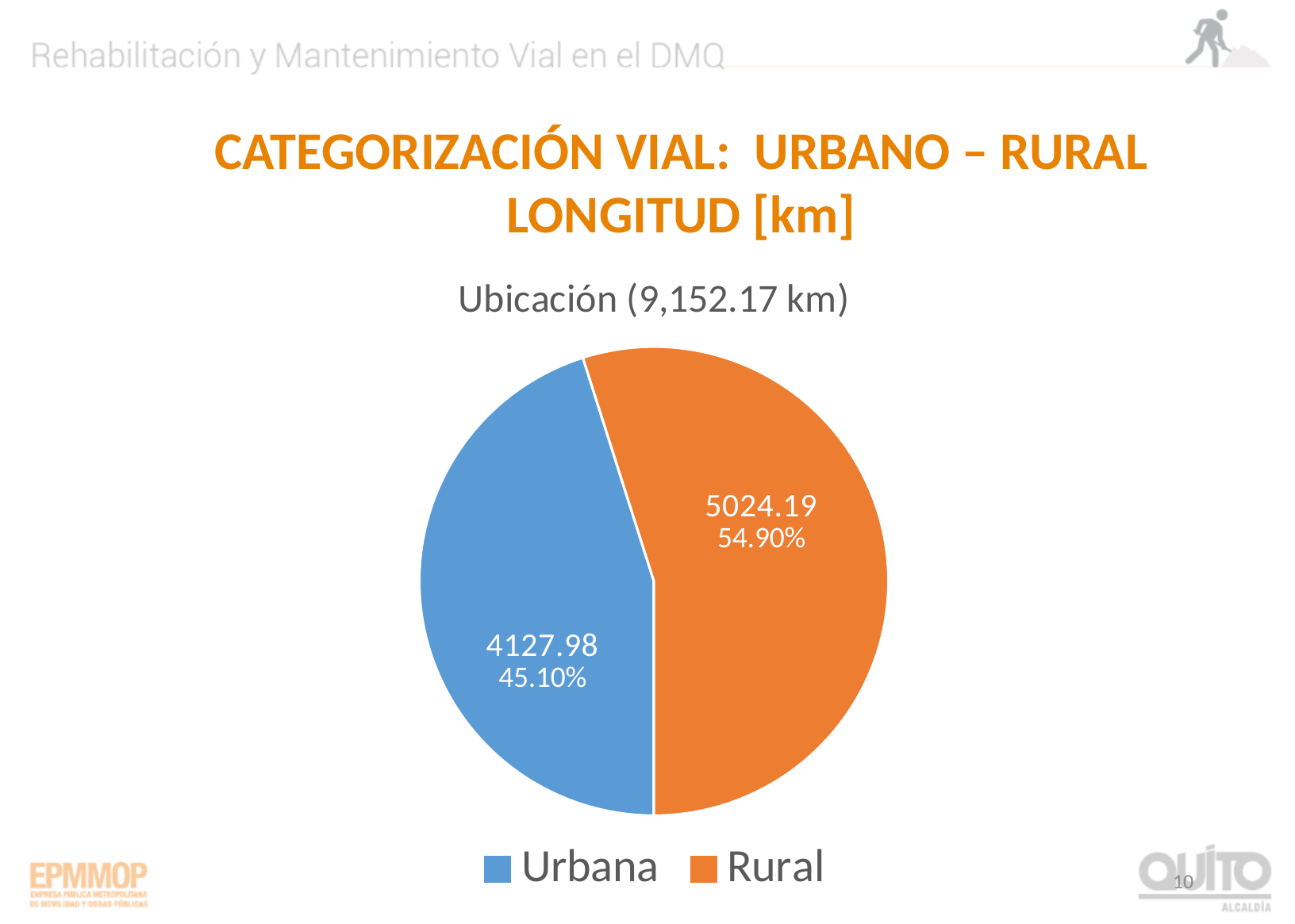
What colour is the Rural slice? Orange Which is larger, Urbana or Rural? Rural Which category has the smallest slice? Urbana What is the difference between the Rural and Urbana values? 896.21 What kind of chart is shown on the slide? Pie chart What is the title of the chart? Ubicación (9,152.17 km) Which category has the largest slice? Rural How many categories does the pie chart show? 2 What share of the pie does Rural represent? 54.90% What is the value for Urbana? 4127.98 What share of the pie does Urbana represent? 45.10% What is the value for Rural? 5024.19